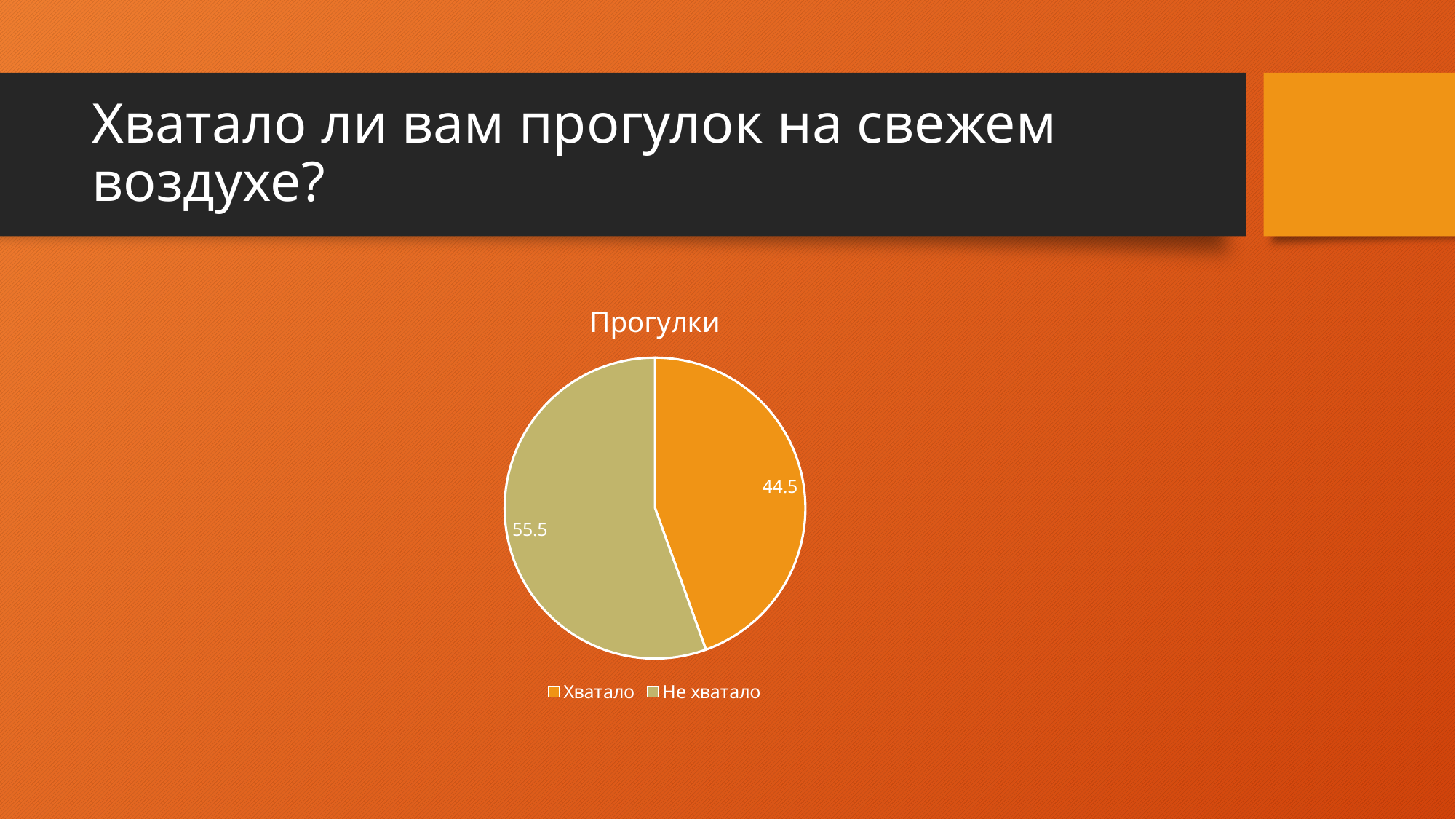
What is the difference between the values for Не хватало and Хватало? 11 What colour is the Хватало slice in the pie chart? orange What is the total of the two slice values in the pie chart? 100 Which category has the largest slice in the pie chart? Не хватало What is the value for Хватало in the pie chart? 44.5 Which category has the smallest slice in the pie chart? Хватало How many entries does the legend list? 2 What is the value for Не хватало in the pie chart? 55.5 What kind of chart is shown on the slide? pie chart What is the title of the chart? Прогулки How many slices does the pie chart have? 2 Which is larger, the value for Хватало or the value for Не хватало? Не хватало